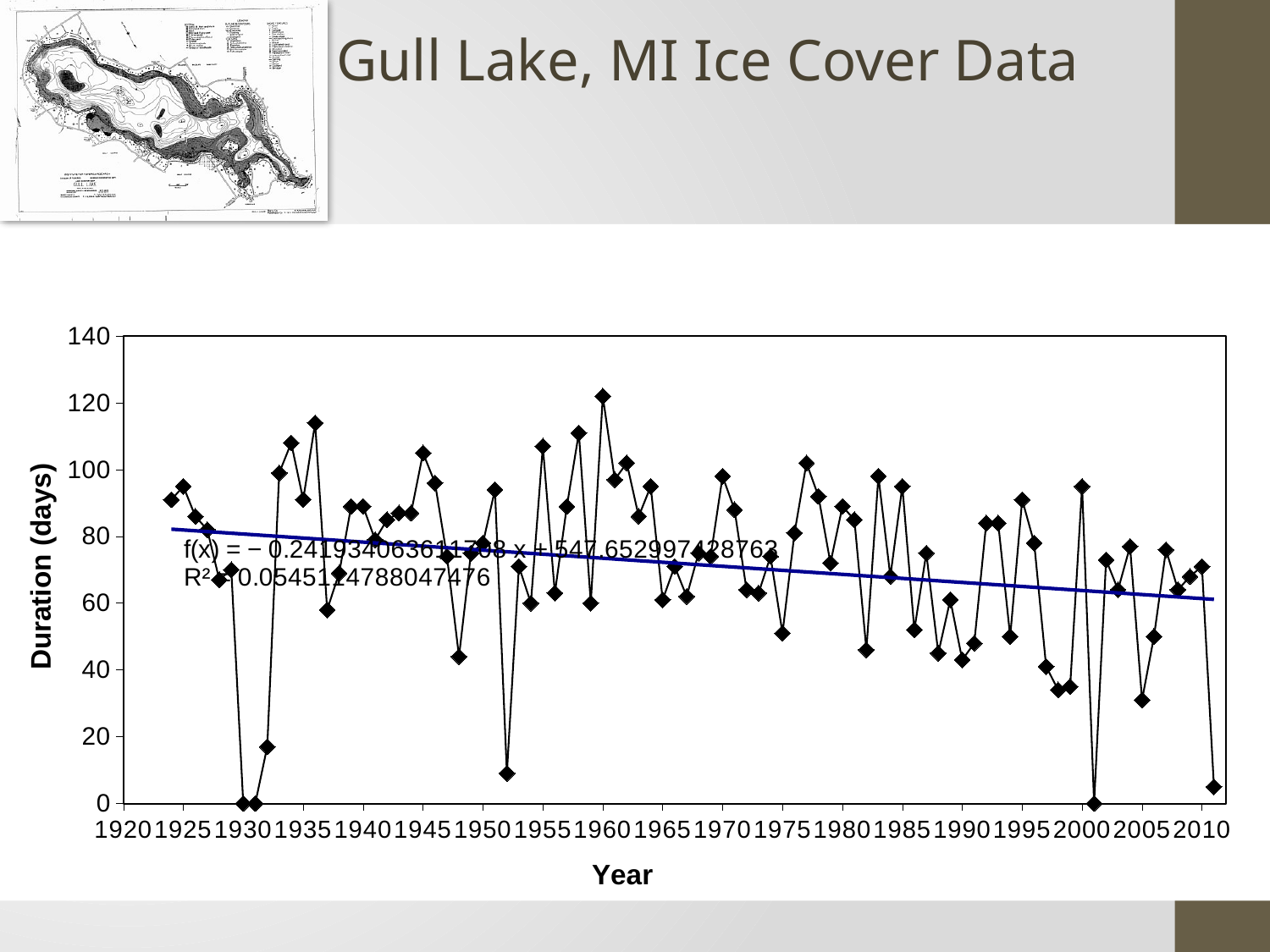
Is the ice cover duration for 1930 greater or less than 20 days? less What kind of chart is shown on the slide? line chart According to the fitted trendline, does ice cover duration rise or fall over the years from 1920 to 2010? fall Is the ice cover duration for 1985 greater or less than 80 days? greater What R² value is printed for the trendline? 0.0545124788047476 What is the label of the vertical axis? Duration (days) Which year has the larger ice cover duration, 1960 or 1930? 1960 Is the ice cover duration for 1975 greater or less than 60 days? less Which year has the larger ice cover duration, 1936 or 1948? 1936 In which year does the ice cover duration reach its highest value? 1960